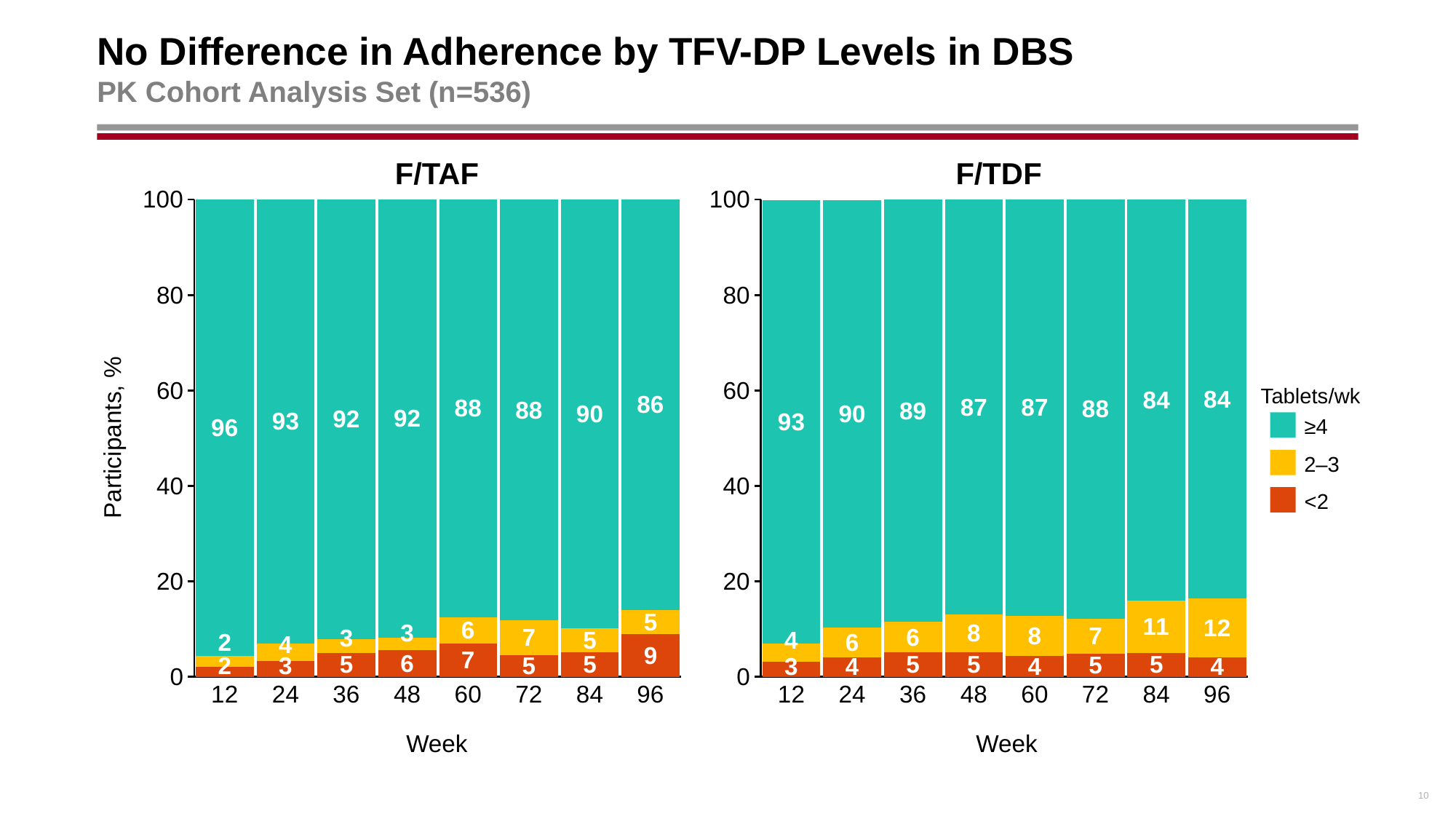
How many weeks (categories) are shown on the x axis of the F/TDF chart? 8 In the F/TDF chart, at which week is the ≥4 tablets/wk value highest? 12 What is the title of the chart on the right? F/TDF In the F/TAF chart, what is the difference between the ≥4 tablets/wk values at week 12 and week 96? 10 How many series does the Tablets/wk legend list? 3 In the F/TAF chart, at which week is the ≥4 tablets/wk value lowest? 96 Which is larger: the ≥4 tablets/wk value at week 48 in the F/TAF chart or in the F/TDF chart? F/TAF In the F/TAF chart, what is the value for <2 tablets/wk at week 96? 9 What kind of chart is the F/TAF chart? Stacked bar chart In the F/TAF chart, what percentage of participants took ≥4 tablets/wk at week 12? 96 In the F/TDF chart, what percentage of participants took 2–3 tablets/wk at week 96? 12 In the F/TDF chart, does the ≥4 tablets/wk value generally rise or fall from week 12 to week 96? Fall